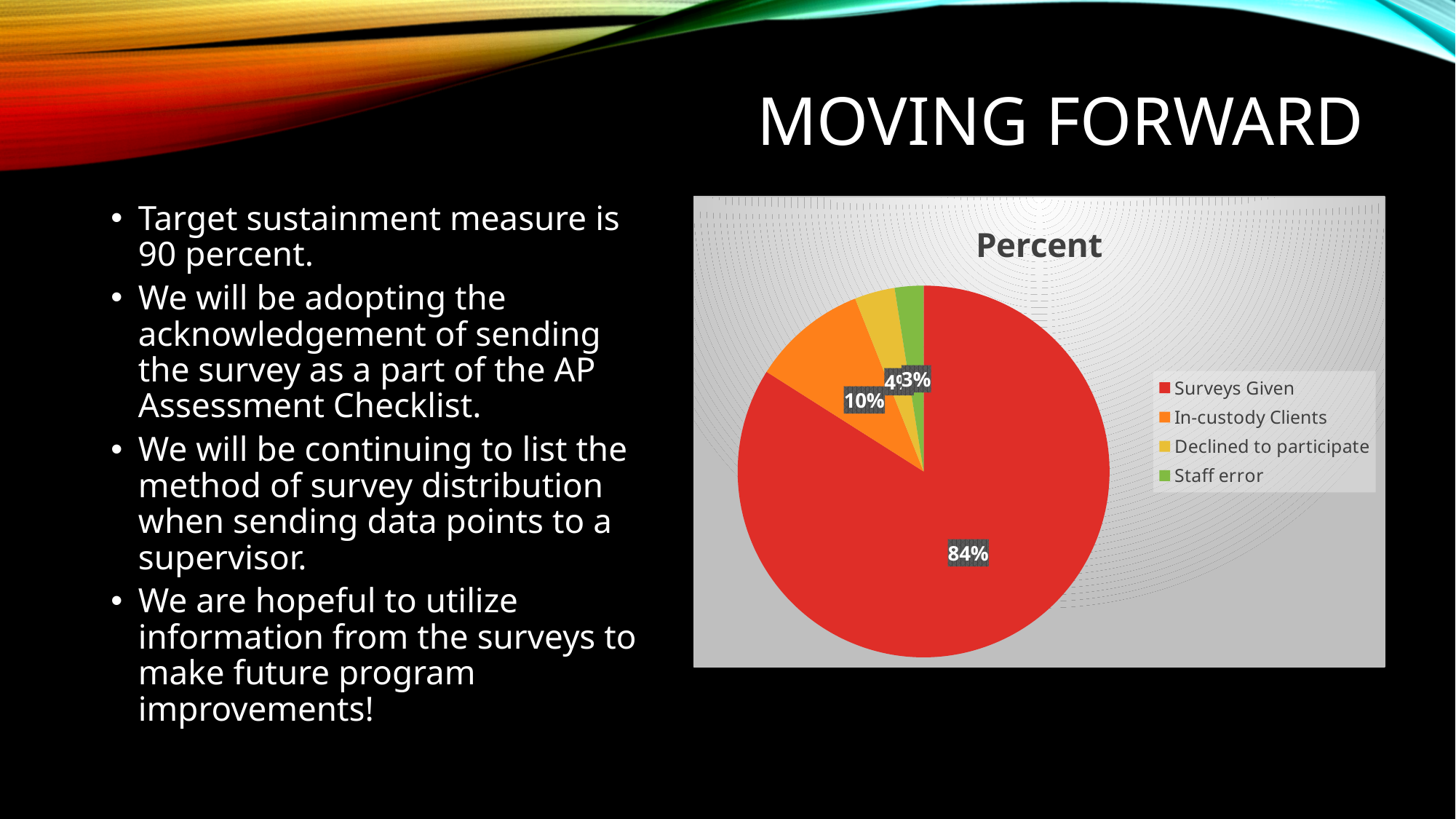
What percentage of the pie is In-custody Clients? 10% Which category has the largest slice of the pie? Surveys Given Which is larger, the In-custody Clients slice or the Staff error slice? In-custody Clients What percentage of the pie is Surveys Given? 84% Is the share for Surveys Given greater or less than 50%? greater Which category has the smallest slice of the pie? Staff error What kind of chart is shown on the slide? pie chart What colour represents Surveys Given in the pie chart? red What percentage of the pie is Staff error? 3% What is the difference in percentage points between Surveys Given and In-custody Clients? 74 How many categories does the legend of the pie chart list? 4 What is the title of the chart? Percent